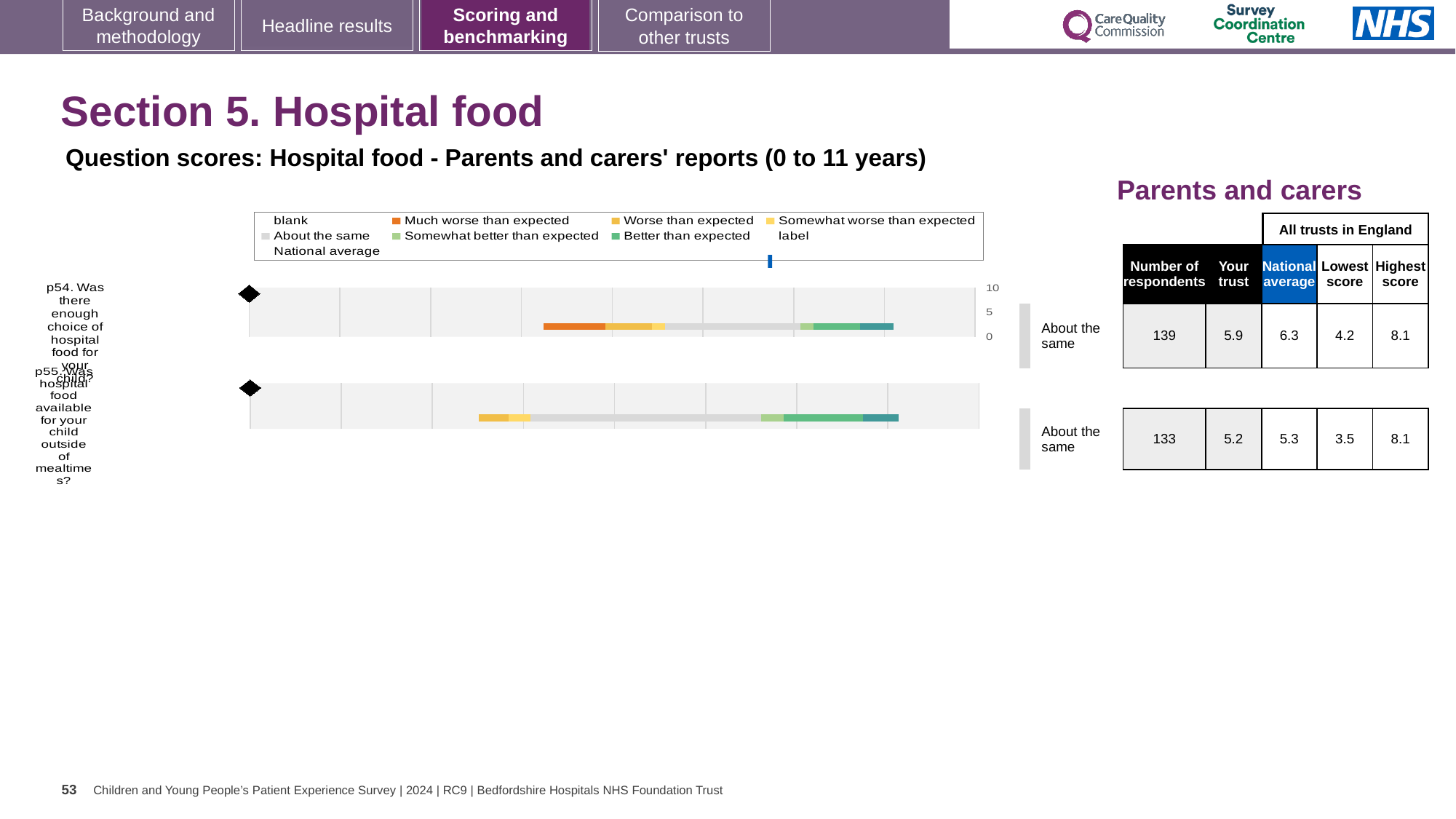
What colour does the legend use for 'Much worse than expected'? Orange What kind of chart is shown on the slide? Bar chart What is the difference between the national average and the 'Your trust' score for question p54? 0.4 What is the 'Your trust' score for question p54? 5.9 What is the difference between the highest and lowest scores for question p54 across all trusts in England? 3.9 How many respondents answered question p54? 139 Which benchmark category is shown for question p54 (enough choice of hospital food)? About the same Which question has the higher 'Your trust' score, p54 or p55? p54 What is the national average score for question p55? 5.3 What is the lowest score among all trusts in England for question p55? 3.5 How many survey questions are plotted as bars in the chart? 2 Which benchmark category is shown for question p55 (hospital food available outside of mealtimes)? About the same